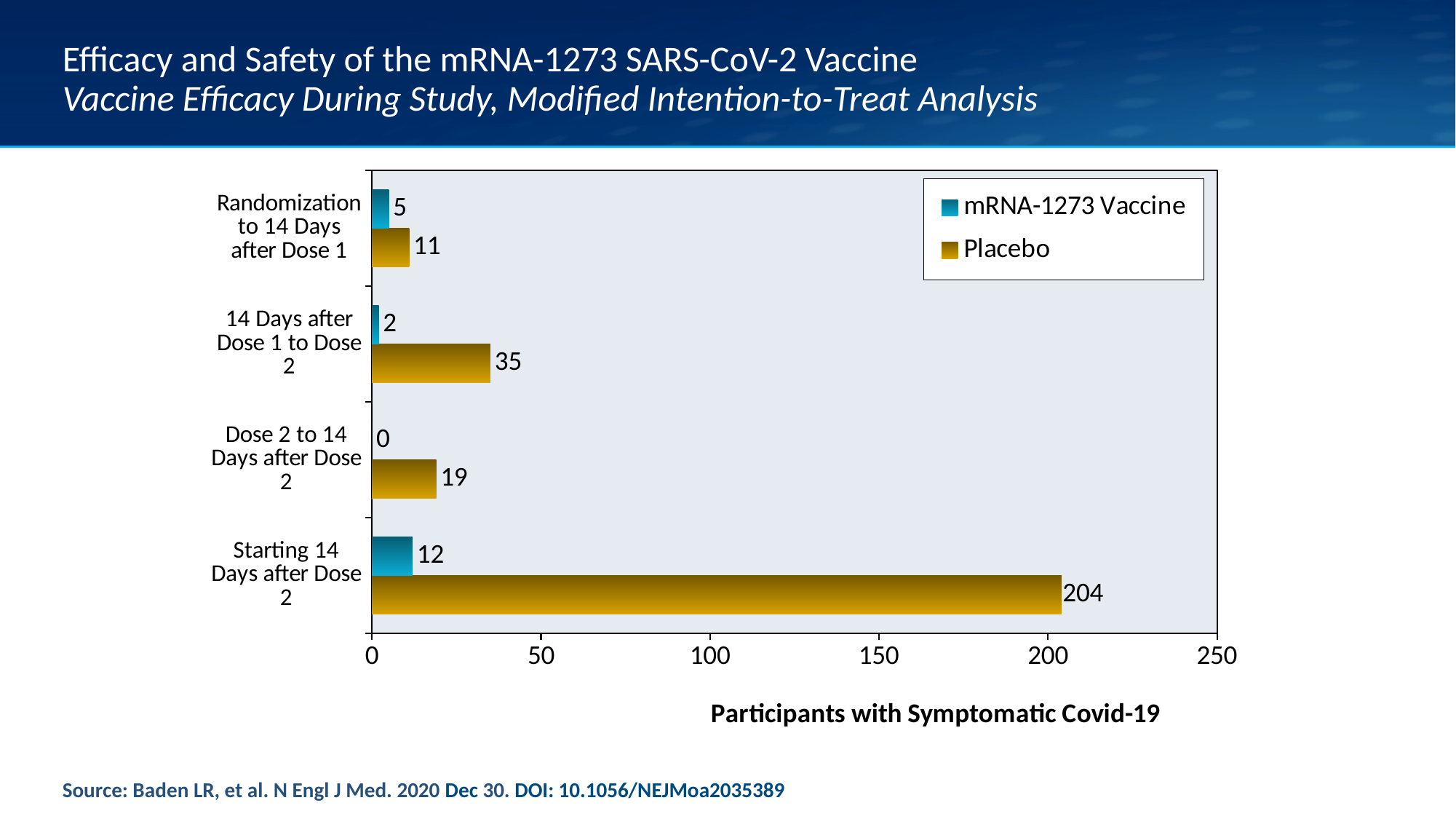
How many time periods are shown on the chart? 4 Is the Placebo value for 'Starting 14 Days after Dose 2' greater or less than 200? greater What is the difference between the Placebo and mRNA-1273 Vaccine values for the 'Starting 14 Days after Dose 2' period? 192 Which is larger for the '14 Days after Dose 1 to Dose 2' period: the Placebo value or the mRNA-1273 Vaccine value? Placebo What is the mRNA-1273 Vaccine value for the 'Dose 2 to 14 Days after Dose 2' period? 0 Which period has the lowest mRNA-1273 Vaccine value? Dose 2 to 14 Days after Dose 2 Which period has the highest Placebo value? Starting 14 Days after Dose 2 What is the mRNA-1273 Vaccine value for the '14 Days after Dose 1 to Dose 2' period? 2 What is the Placebo value for the 'Randomization to 14 Days after Dose 1' period? 11 What is the Placebo value for the 'Starting 14 Days after Dose 2' period? 204 How many series does the legend list? 2 What kind of chart is shown on the slide? Bar chart